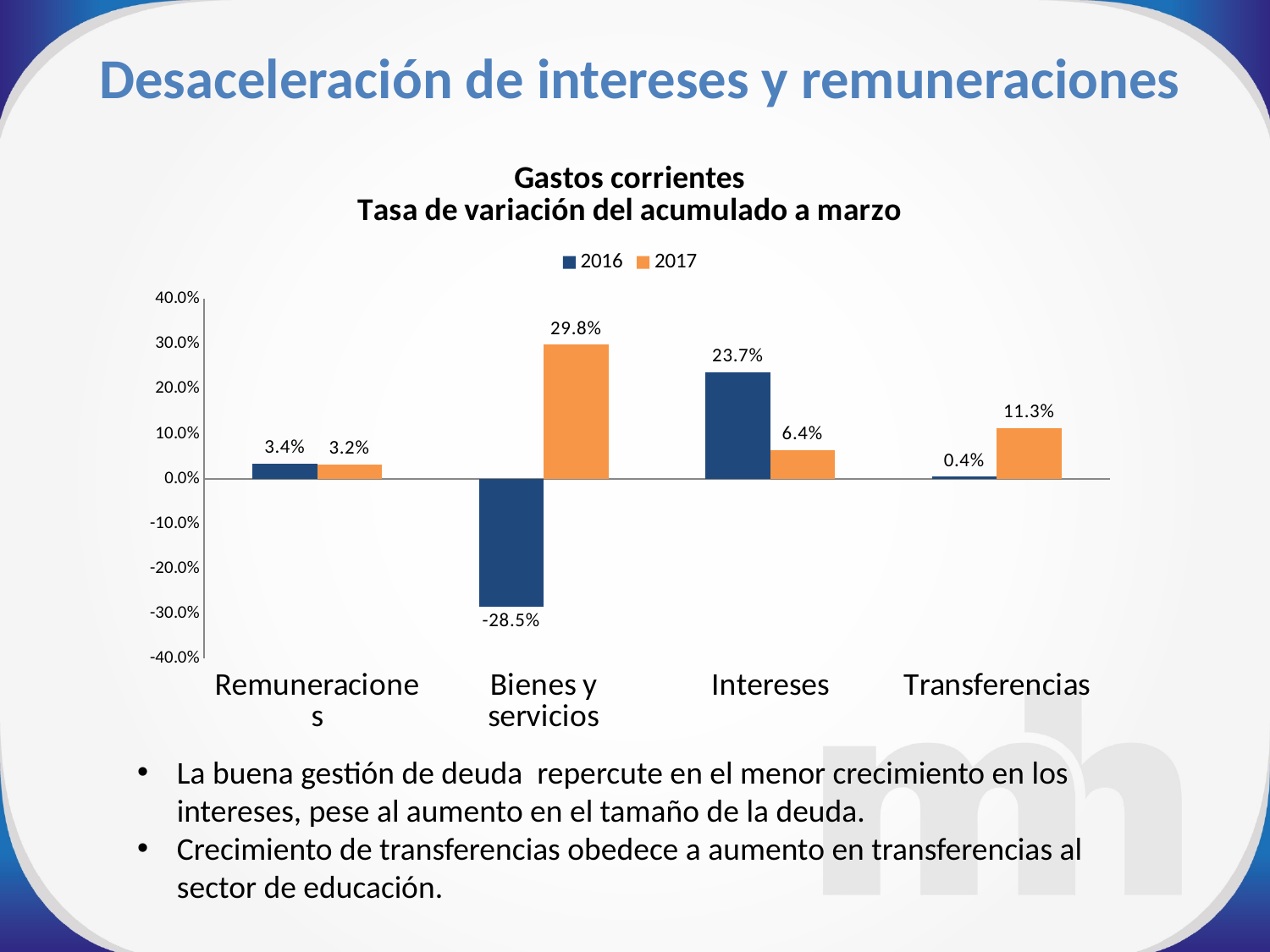
What is the title of the chart? Gastos corrientes Tasa de variación del acumulado a marzo What kind of chart is shown on the slide? Bar chart Which category has the lowest 2016 value? Bienes y servicios Which is larger for Transferencias, the 2016 value or the 2017 value? 2017 What is the 2017 value for Bienes y servicios? 29.8% What is the 2017 value for Transferencias? 11.3% What is the 2016 value for Intereses? 23.7% Which category has the highest 2017 value? Bienes y servicios What is the 2016 value for Bienes y servicios? -28.5% What is the difference between the 2016 and 2017 values for Intereses? 17.3% How many series does the legend list? 2 How many categories are shown on the x axis? 4